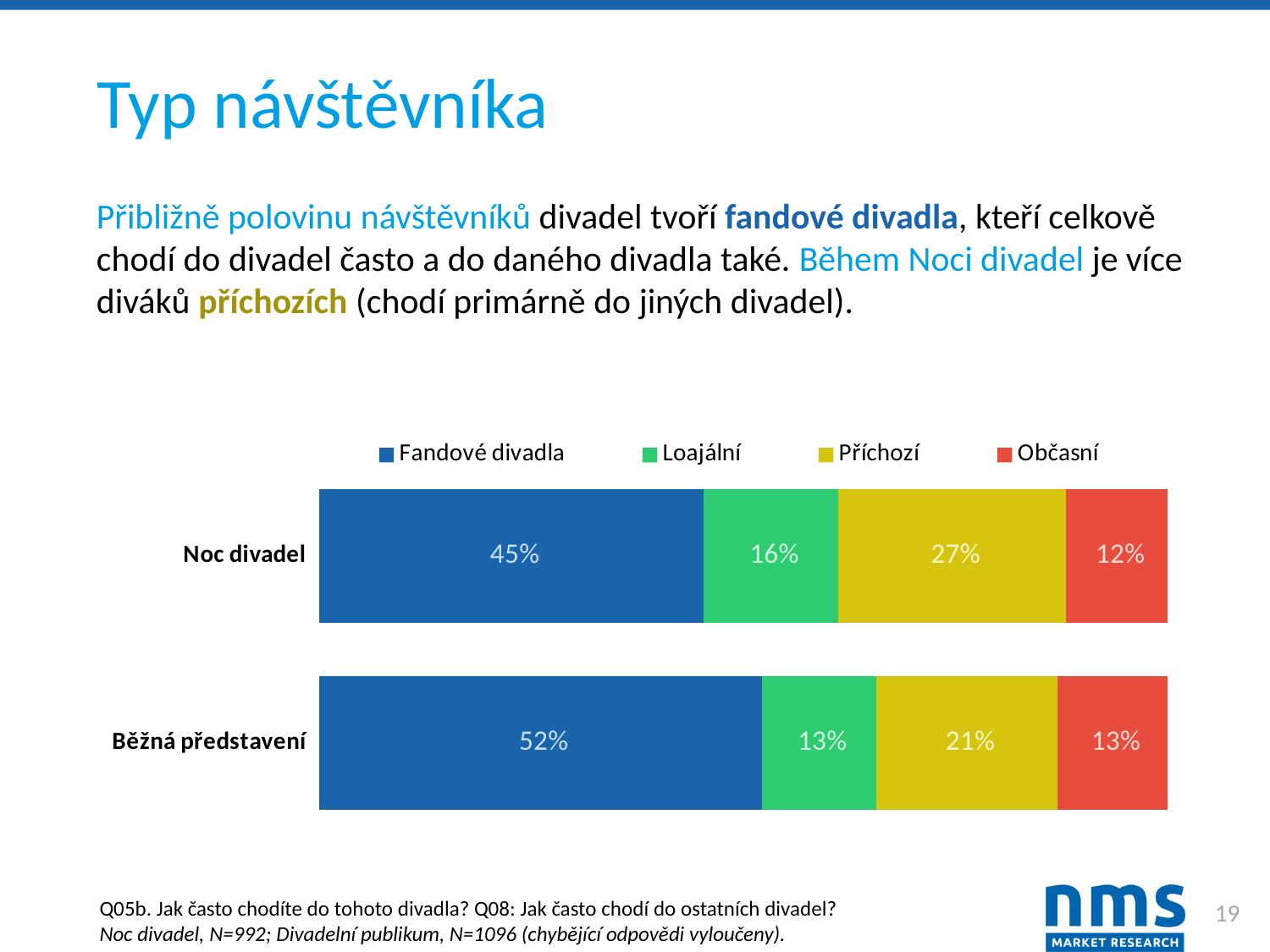
What is the value for Loajální in the Noc divadel bar? 16% What is the value for Příchozí in the Běžná představení bar? 21% Which series has the highest value in the Běžná představení bar? Fandové divadla How many categories (bars) are shown in the chart? 2 Which series has the lowest value in the Noc divadel bar? Občasní What is the difference between the Fandové divadla values for Běžná představení and Noc divadel? 7% What is the value for Občasní in the Běžná představení bar? 13% Which is larger: the Příchozí value for Noc divadel or for Běžná představení? Noc divadel What kind of chart is shown on the slide? Stacked bar chart What colour represents the Příchozí series in the chart? Yellow What is the value for Fandové divadla in the Noc divadel bar? 45% How many series does the legend list? 4